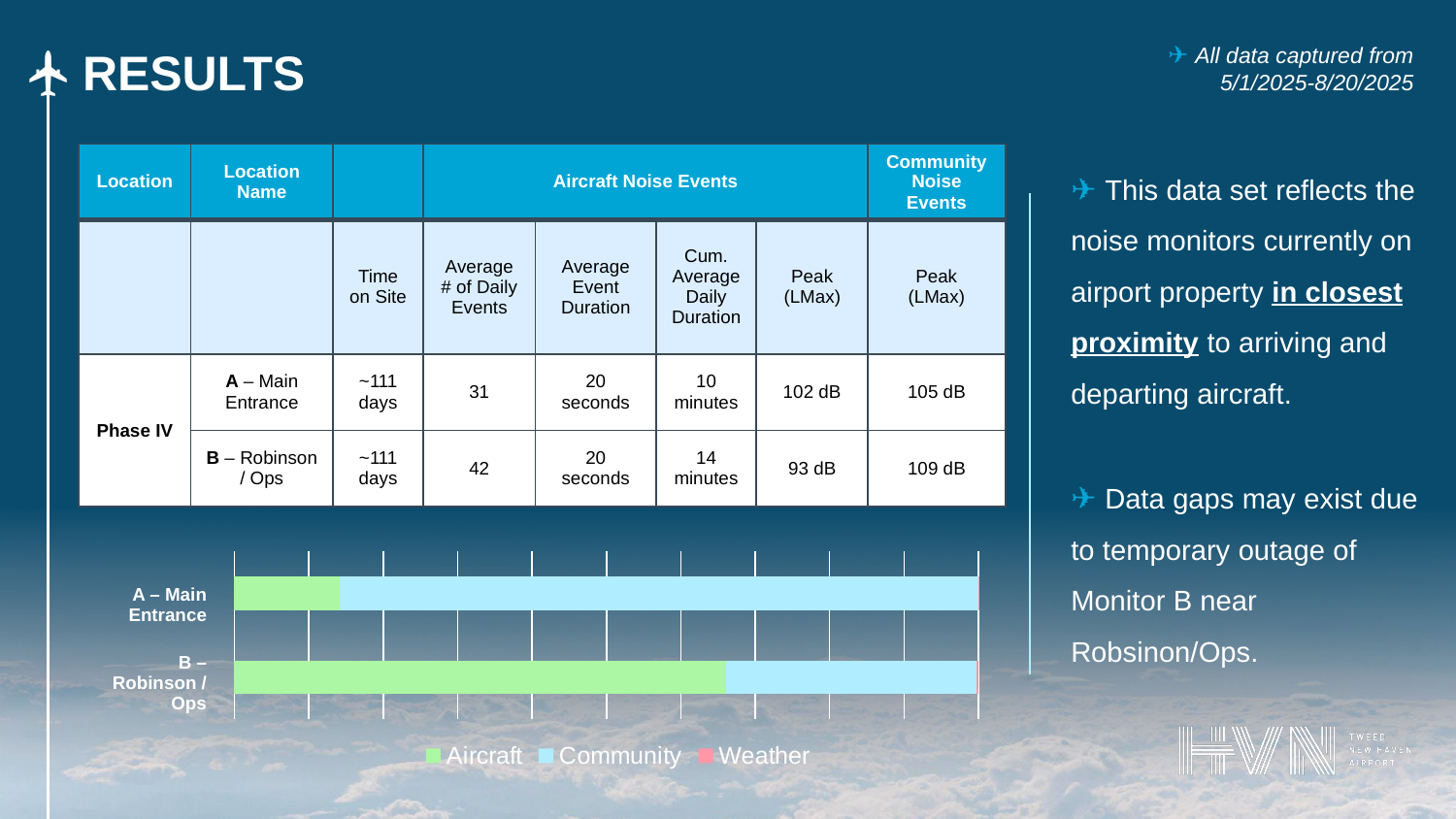
Which location has the larger Community segment in the bar chart, A – Main Entrance or B – Robinson / Ops? A – Main Entrance Which location's bar has the largest Aircraft share? B – Robinson / Ops How many series does the bar chart's legend list? 3 For B – Robinson / Ops, which segment is larger in the bar chart, Aircraft or Community? Aircraft Which series are listed in the bar chart's legend? Aircraft, Community, Weather For A – Main Entrance, which segment is larger in the bar chart, Aircraft or Community? Community Which series has the smallest segment in both bars of the chart? Weather What colour represents the Aircraft series in the bar chart? Green How many categories (locations) are plotted in the bar chart? 2 What kind of chart is shown on the slide? Stacked bar chart